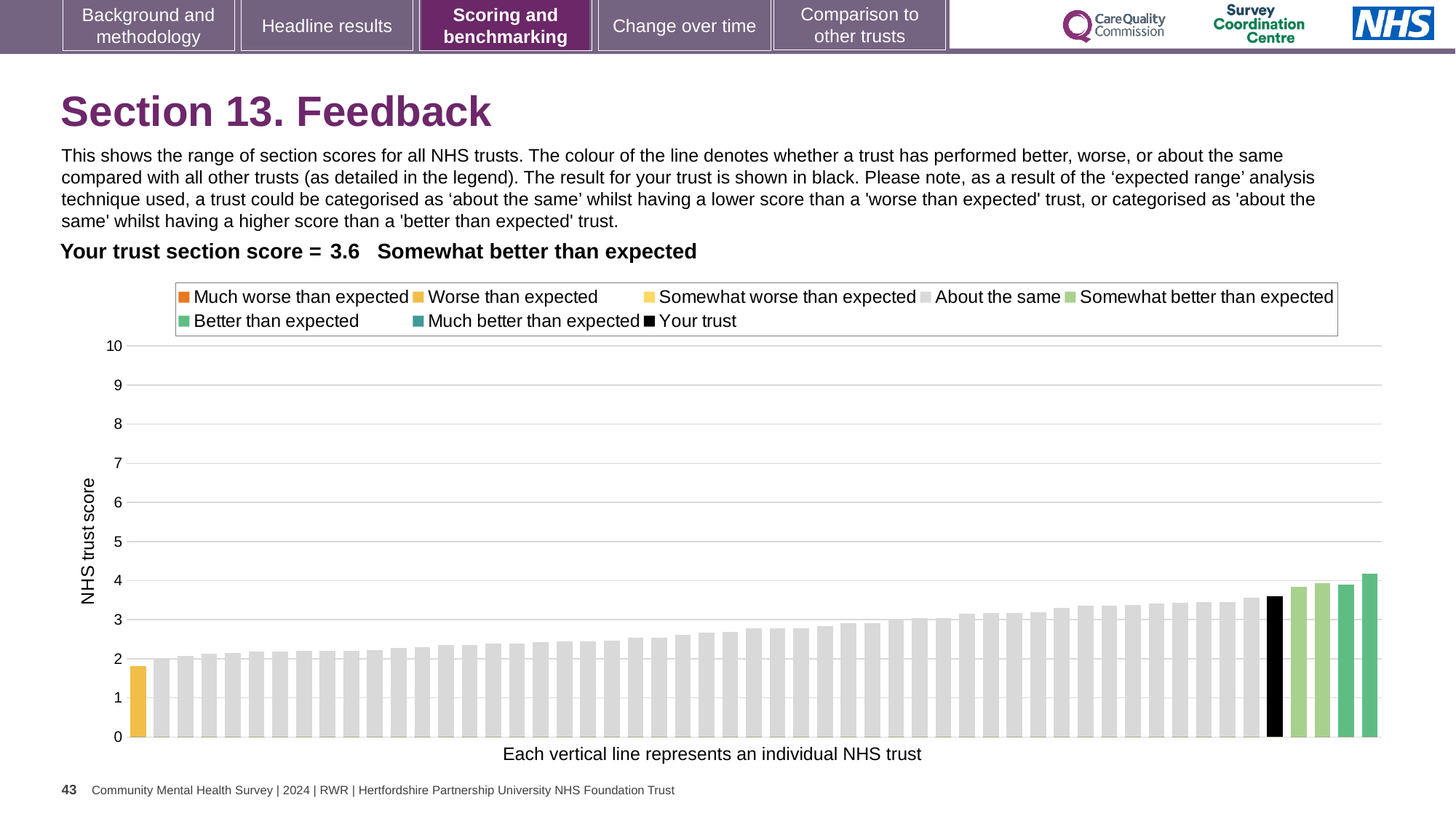
What colour is used for the bar representing your trust? black Do the bar values rise or fall from left to right along the x axis? rise How many entries does the chart legend list? 8 Is the value for your trust (black bar) greater or less than 3? greater What is the label on the vertical axis of the chart? NHS trust score Is the value of the leftmost (lowest) bar greater or less than 2? less Is the value of the highest bar greater or less than 5? less What kind of chart is shown on the slide? bar chart Which is larger: the value for your trust (black bar) or the value of the leftmost bar? your trust How many bars are coloured as 'Better than expected' (dark green)? 2 What is the section score for your trust shown on the slide? 3.6